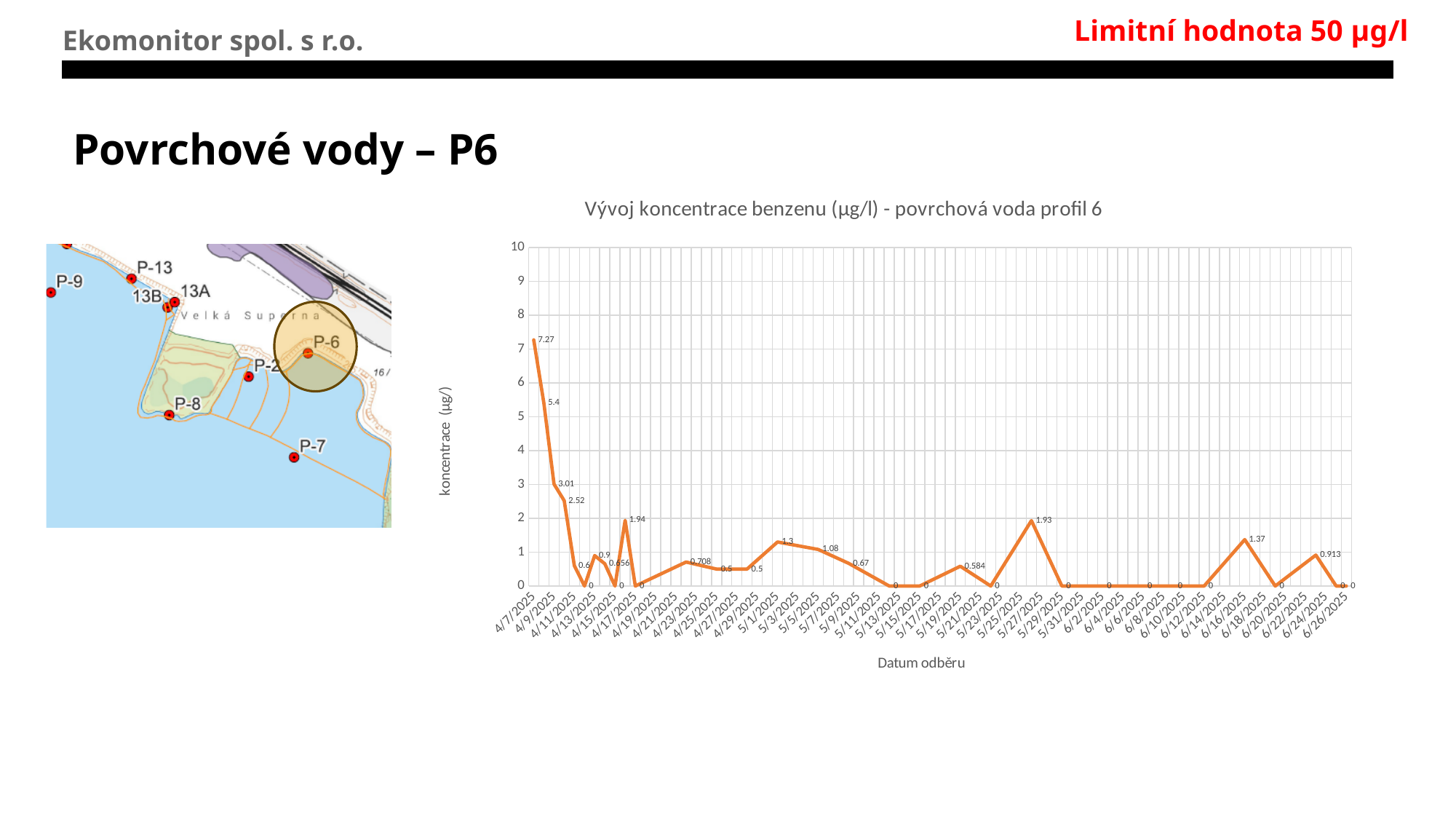
What is the label of the x axis of the chart? Datum odběru Overall, does the benzene concentration rise or fall from the start to the end of the period shown? fall Is the benzene concentration on 4/7/2025 greater or less than 5? greater What is the title of the chart? Vývoj koncentrace benzenu (µg/l) - povrchová voda profil 6 On which date is the benzene concentration highest? 4/7/2025 What type of chart is shown on the slide? line chart What is the benzene concentration on 6/26/2025? 0 Is the benzene concentration on 4/17/2025 greater or less than 3? less What is the benzene concentration on 4/7/2025? 7.27 What is the highest benzene concentration value shown on the chart? 7.27 What is the benzene concentration on 4/17/2025? 0